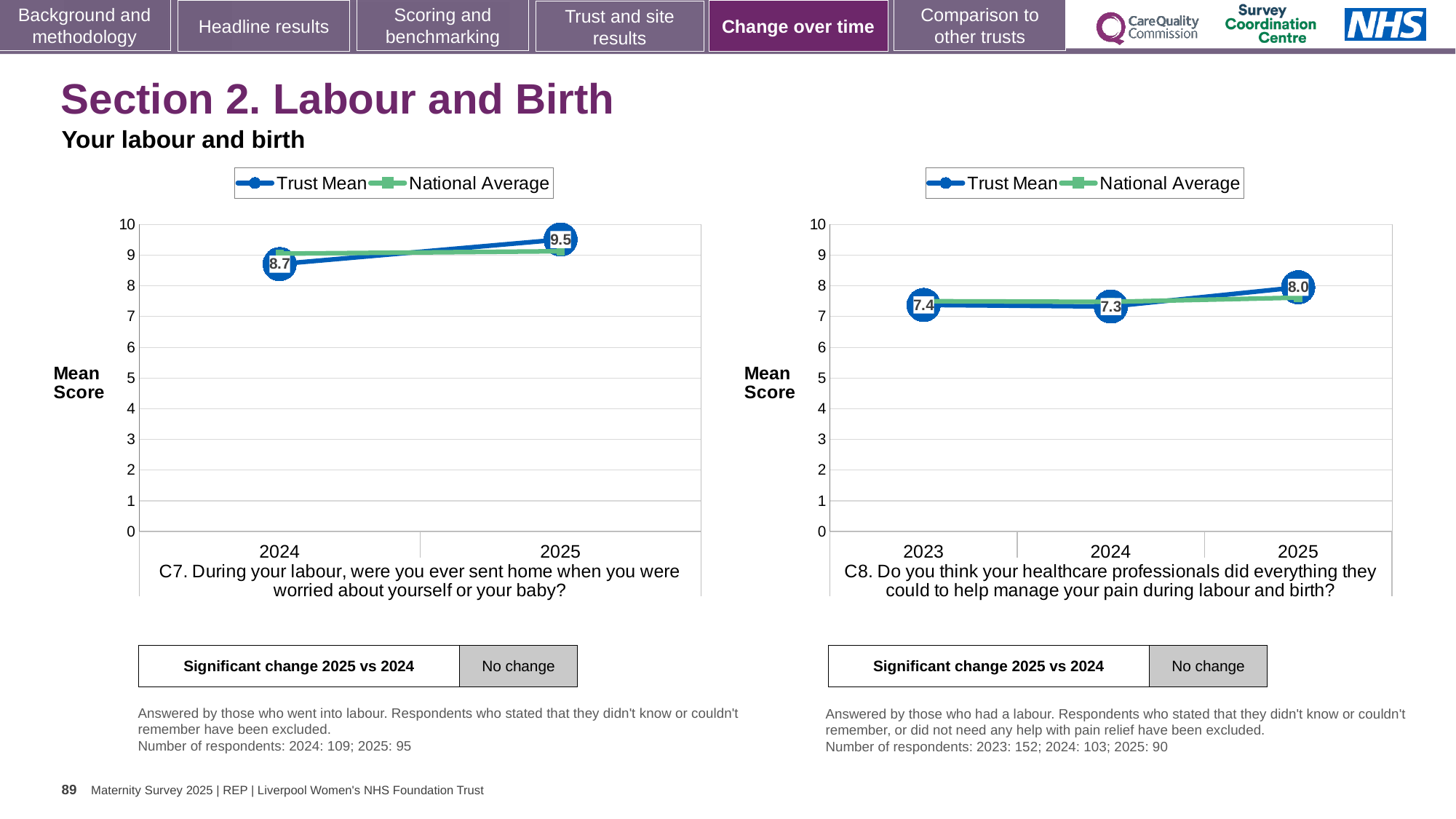
On the right chart (C8), what is the difference between the Trust Mean in 2025 and in 2024? 0.7 On the left chart (C7), what is the Trust Mean score for 2024? 8.7 On the right chart (C8), what is the Trust Mean score for 2023? 7.4 On the right chart (C8), is the National Average for 2025 greater or less than 7? greater On the right chart (C8), which year has the highest Trust Mean score? 2025 What kind of chart is the left chart (C7)? line chart On the left chart (C7), by how much did the Trust Mean change from 2024 to 2025? 0.8 On the left chart (C7), does the Trust Mean rise or fall from 2024 to 2025? rise How many series does the legend of the right chart (C8) list? 2 On the right chart (C8), what is the Trust Mean score for 2025? 8.0 On the left chart (C7), what is the Trust Mean score for 2025? 9.5 On the left chart (C7), how many years are shown on the x axis? 2